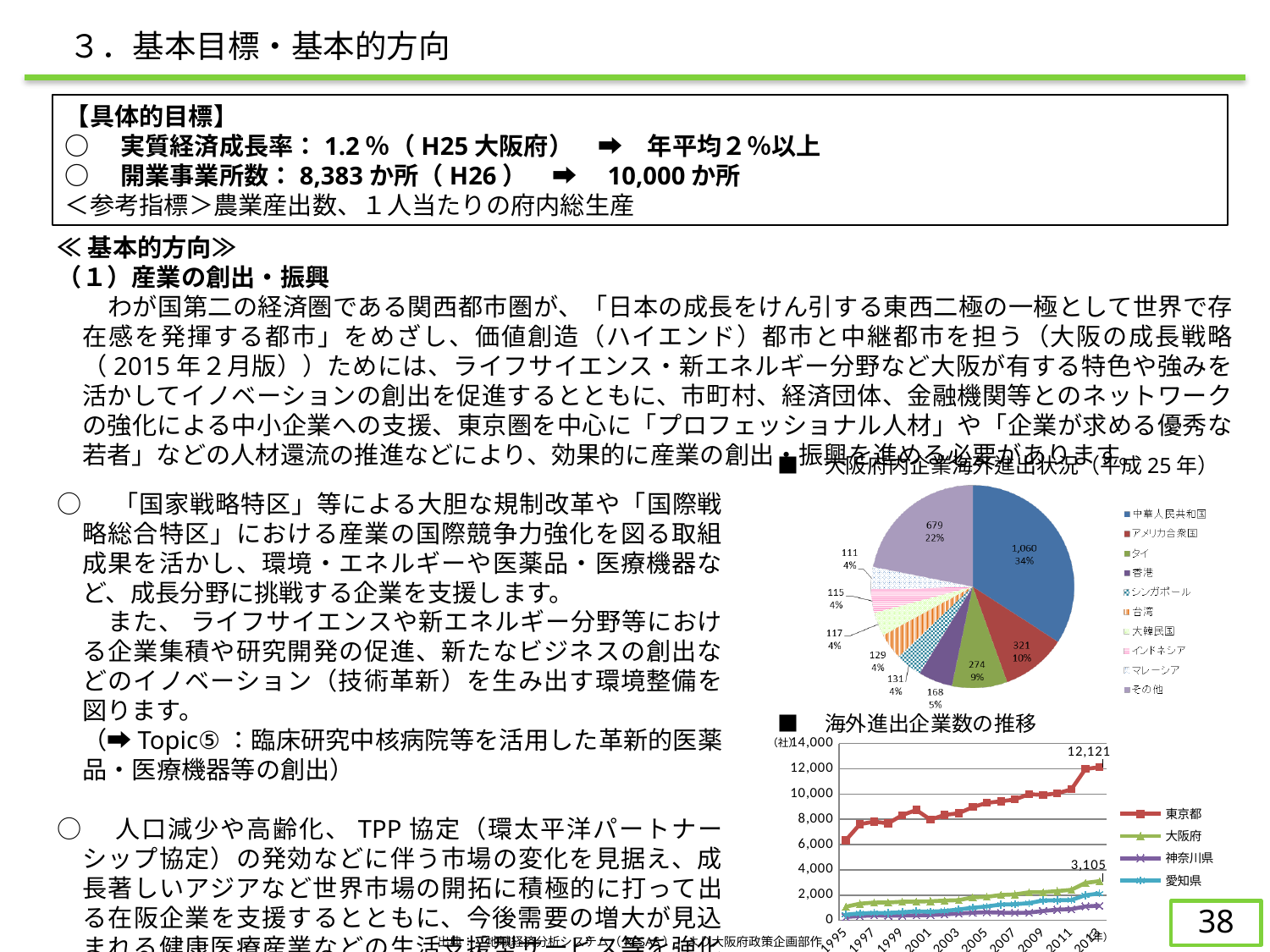
How many categories does the legend of the pie chart 大阪府内企業海外進出状況（平成25年） list? 10 In the chart 海外進出企業数の推移, is the value for 東京都 in 1995 greater or less than 8,000? less What kind of chart is 大阪府内企業海外進出状況（平成25年）? pie chart In the pie chart 大阪府内企業海外進出状況（平成25年）, what share of the pie does その他 hold? 22% In the chart 海外進出企業数の推移, what is the labelled value for 東京都 in 2013? 12,121 In the pie chart 大阪府内企業海外進出状況（平成25年）, which category has the largest slice? 中華人民共和国 In the pie chart 大阪府内企業海外進出状況（平成25年）, what is the value for アメリカ合衆国? 321 In the chart 海外進出企業数の推移, does the 東京都 series generally rise or fall from 1995 to 2013? rise How many series does the legend of the chart 海外進出企業数の推移 list? 4 In the chart 海外進出企業数の推移, what is the difference between the 2013 values for 東京都 (12,121) and 大阪府 (3,105)? 9,016 In the pie chart 大阪府内企業海外進出状況（平成25年）, what share of the pie does 中華人民共和国 hold? 34% In the pie chart 大阪府内企業海外進出状況（平成25年）, what is the value for 中華人民共和国? 1,060